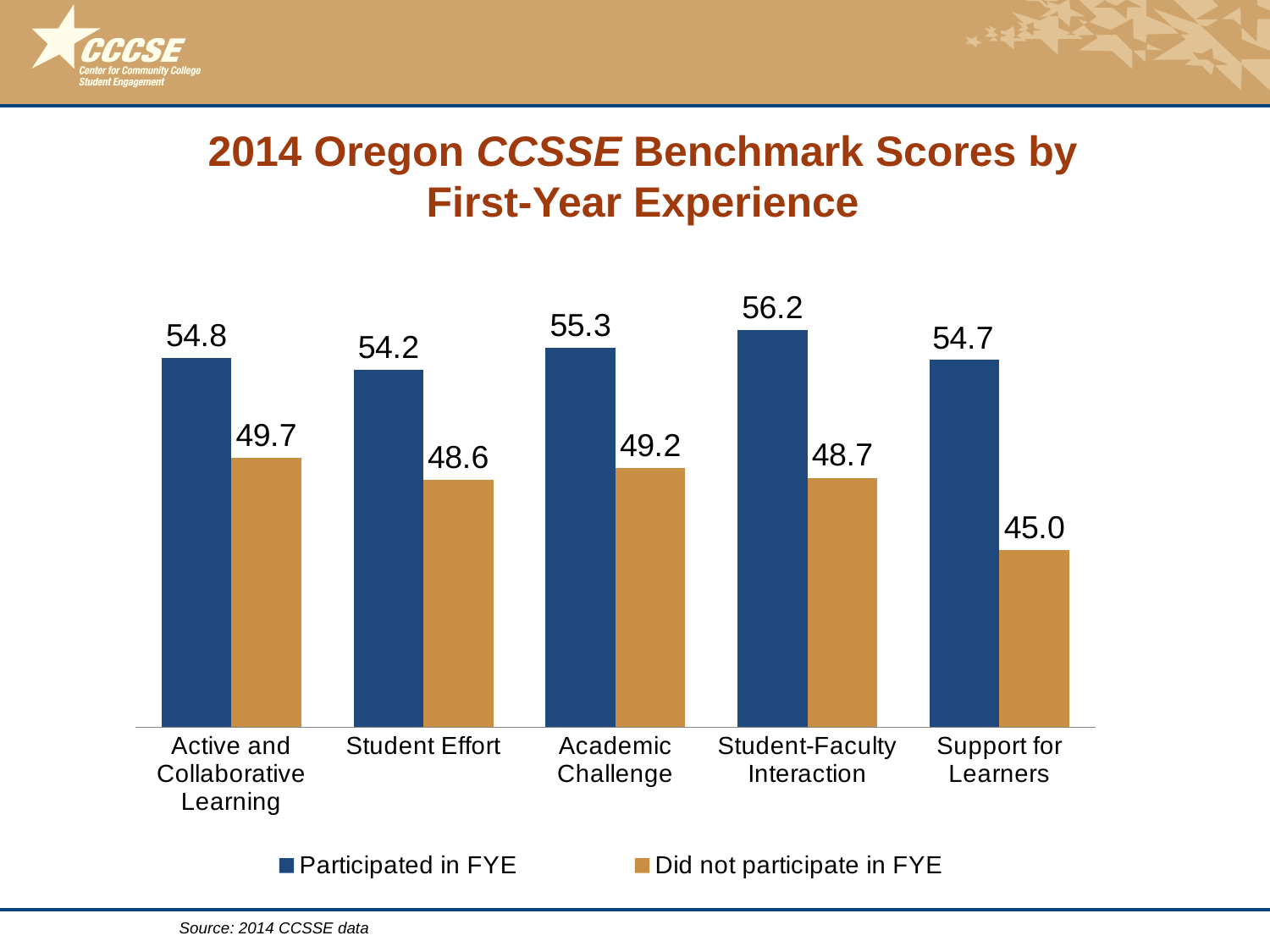
Which is larger for Active and Collaborative Learning: Participated in FYE or Did not participate in FYE? Participated in FYE Which category has the highest value for Participated in FYE? Student-Faculty Interaction What is the difference between Participated in FYE and Did not participate in FYE for Academic Challenge? 6.1 What is the value for Participated in FYE for Student-Faculty Interaction? 56.2 What is the value for Did not participate in FYE for Support for Learners? 45.0 What is the difference between Participated in FYE and Did not participate in FYE for Support for Learners? 9.7 What kind of chart is shown on the slide? Bar chart How many categories are shown on the x axis? 5 Which category has the lowest value for Did not participate in FYE? Support for Learners How many series does the legend list? 2 What is the value for Did not participate in FYE for Student Effort? 48.6 What is the title of the chart? 2014 Oregon CCSSE Benchmark Scores by First-Year Experience